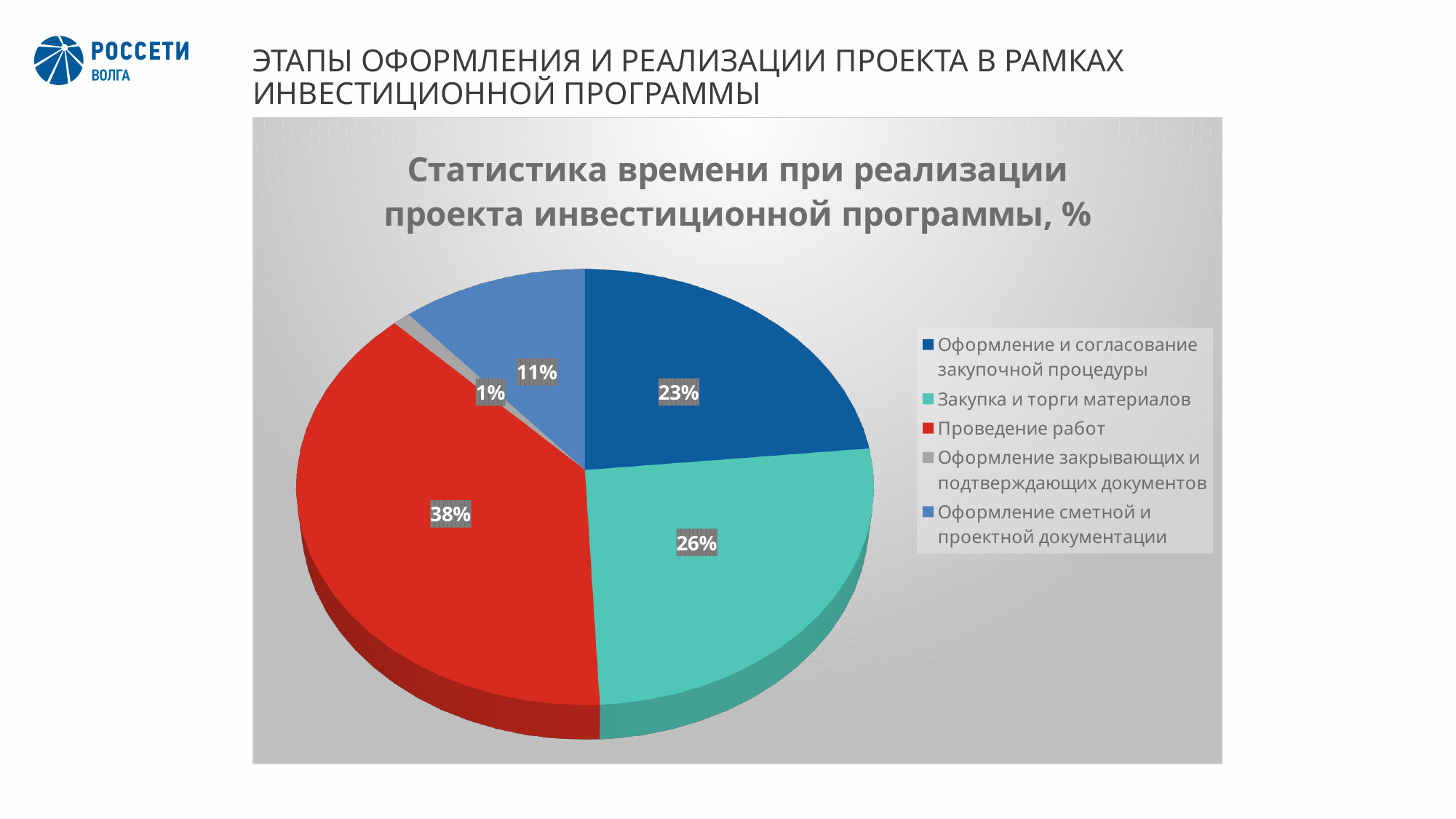
How many categories does the legend list? 5 What share of the pie is labelled for "Оформление и согласование закупочной процедуры"? 23% What kind of chart is shown on the slide? Pie chart Which category has the largest slice of the pie? Проведение работ What share of the pie is labelled for "Оформление закрывающих и подтверждающих документов"? 1% What is the title of the chart? Статистика времени при реализации проекта инвестиционной программы, % What share of the pie is labelled for "Закупка и торги материалов"? 26% What is the difference in percentage points between "Проведение работ" and "Закупка и торги материалов"? 12 Which is larger: the slice for "Закупка и торги материалов" or the slice for "Оформление и согласование закупочной процедуры"? Закупка и торги материалов Which category has the smallest slice of the pie? Оформление закрывающих и подтверждающих документов